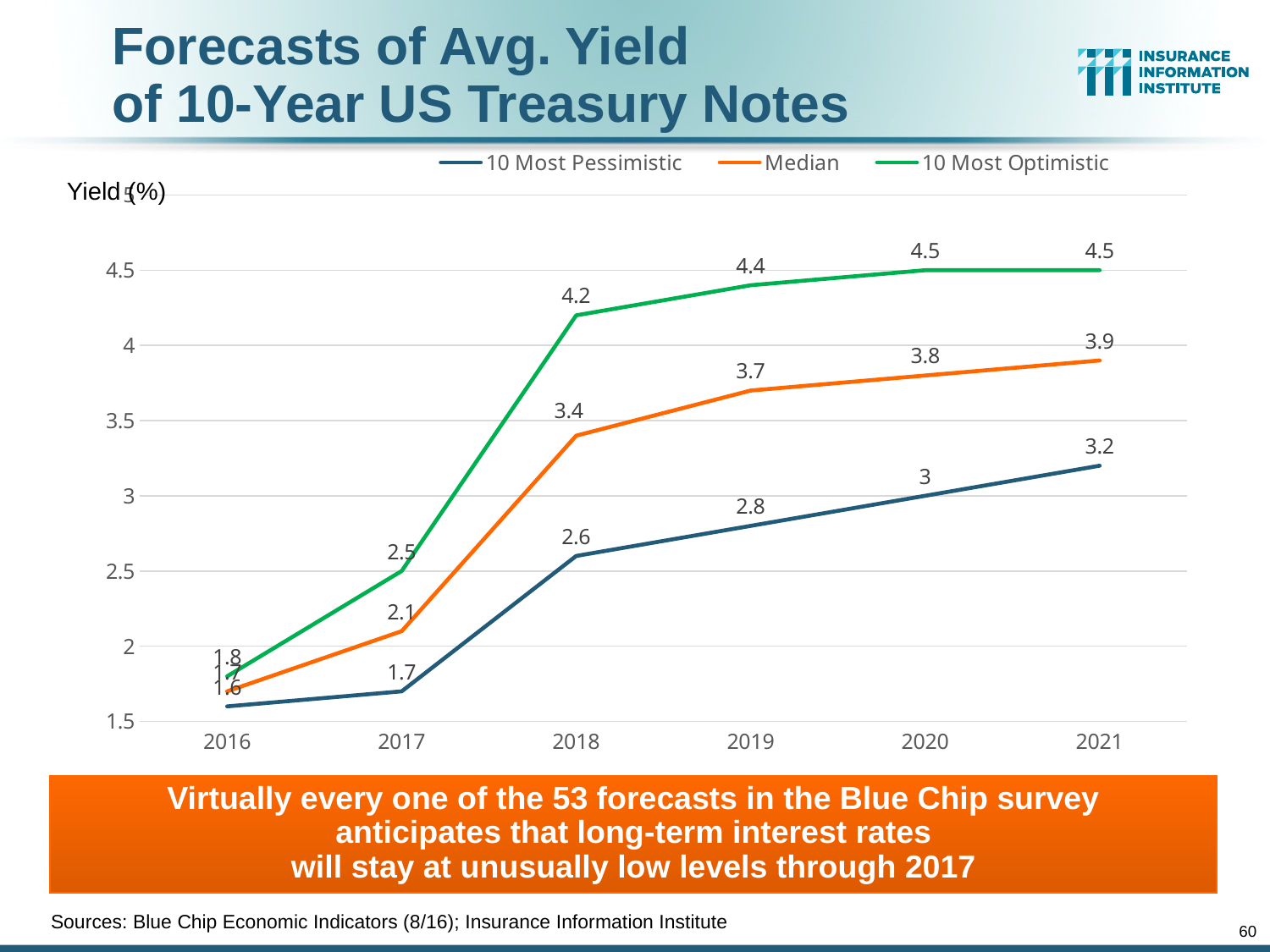
What is the title of the chart? Forecasts of Avg. Yield of 10-Year US Treasury Notes In which year is the 10 Most Pessimistic forecast highest? 2021 Does the Median forecast rise or fall from 2016 to 2021? rise What is the 10 Most Optimistic forecast yield for 2021? 4.5 What kind of chart is shown on the slide? line chart How many series does the legend list? 3 Which is larger in 2017: the Median forecast or the 10 Most Optimistic forecast? 10 Most Optimistic In which year is the Median forecast lowest? 2016 How many years are shown on the x axis? 6 What is the Median forecast yield for 2018? 3.4 What is the 10 Most Pessimistic forecast yield for 2019? 2.8 What is the difference between the 10 Most Optimistic and 10 Most Pessimistic forecasts for 2020? 1.5